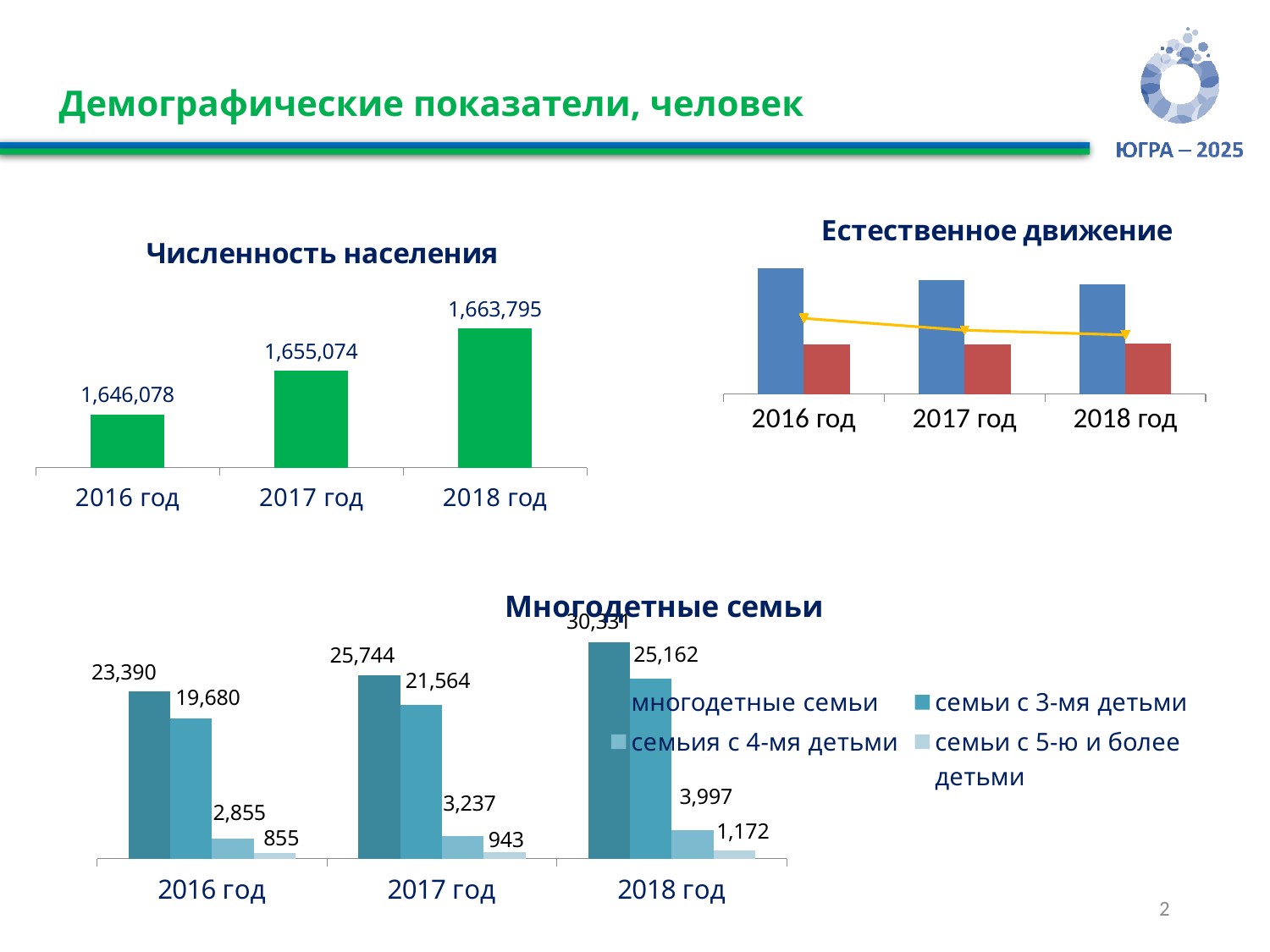
How many series does the legend of the 'Многодетные семьи' chart list? 4 In the 'Многодетные семьи' chart, which year has the lowest value for 'семьи с 5-ю и более детьми'? 2016 год In the 'Численность населения' chart, what is the value for 2016 год? 1,646,078 In the 'Численность населения' chart, what is the difference between the 2018 год and 2016 год values? 17,717 In the 'Численность населения' chart, do the values rise or fall from 2016 год to 2018 год? rise In the 'Естественное движение' chart, how many year categories are shown on the x axis? 3 In the 'Численность населения' chart, what is the value for 2018 год? 1,663,795 In the 'Многодетные семьи' chart, what is the difference between the 'многодетные семьи' values for 2017 год and 2016 год? 2,354 In the 'Естественное движение' chart, for 2016 год, which bar is taller, the blue one or the red one? the blue one In the 'Многодетные семьи' chart, what is the value for 'семьи с 3-мя детьми' in 2017 год? 21,564 In the 'Естественное движение' chart, does the yellow line rise or fall from 2016 год to 2018 год? fall What kind of chart is the 'Естественное движение' chart? combination bar and line chart